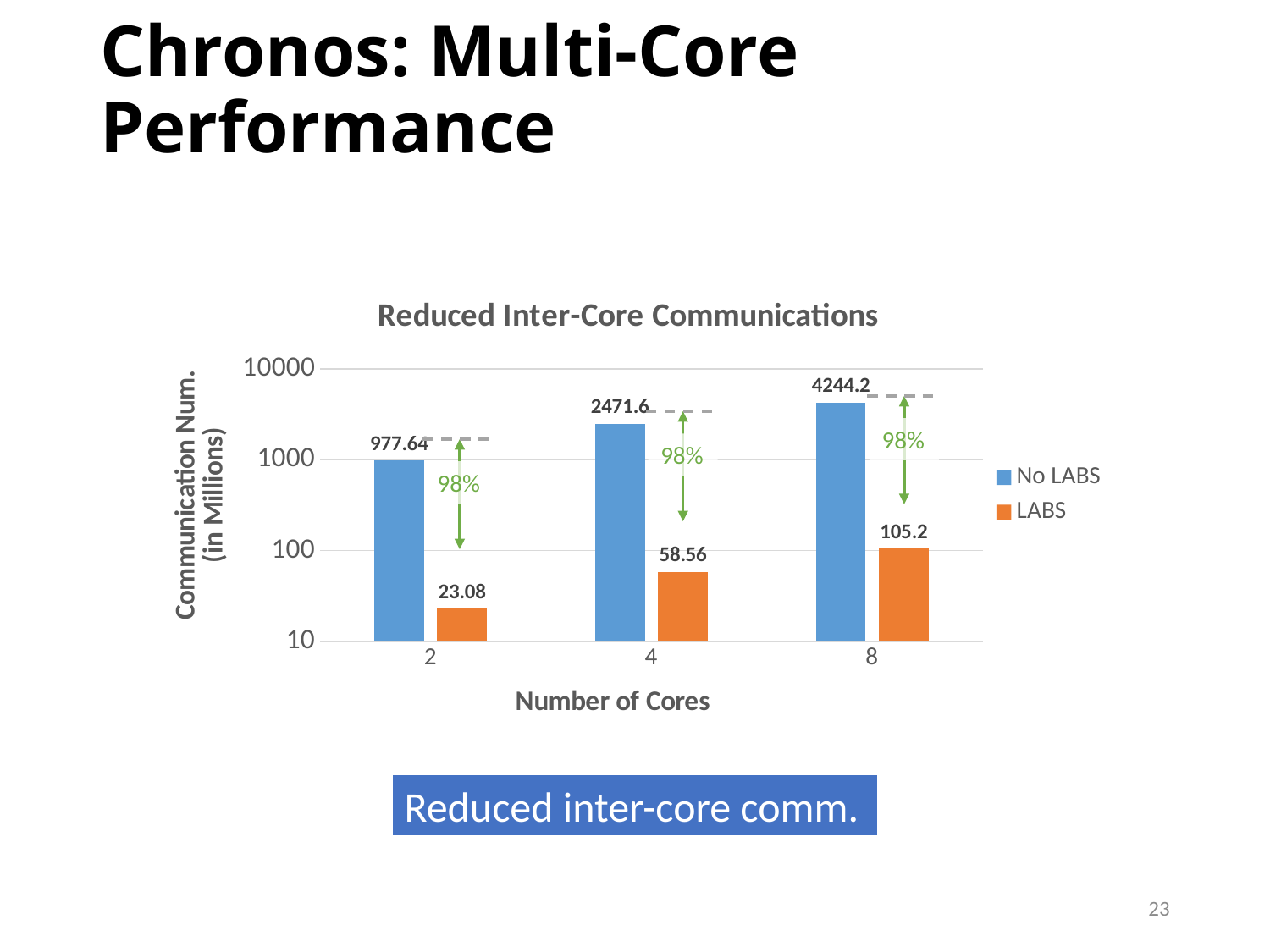
What is the LABS value for 2 cores? 23.08 What is the No LABS value for 8 cores? 4244.2 What is the No LABS value for 2 cores? 977.64 Which number of cores has the lowest No LABS value? 2 How many series does the legend list? 2 What is the difference between the No LABS and LABS values for 8 cores? 4139 What kind of chart is shown? bar chart Which is larger: the LABS value for 8 cores or the LABS value for 4 cores? LABS value for 8 cores How many categories are shown on the x axis? 3 Do the No LABS values rise or fall as the number of cores increases? rise Which number of cores has the highest LABS value? 8 What is the LABS value for 4 cores? 58.56